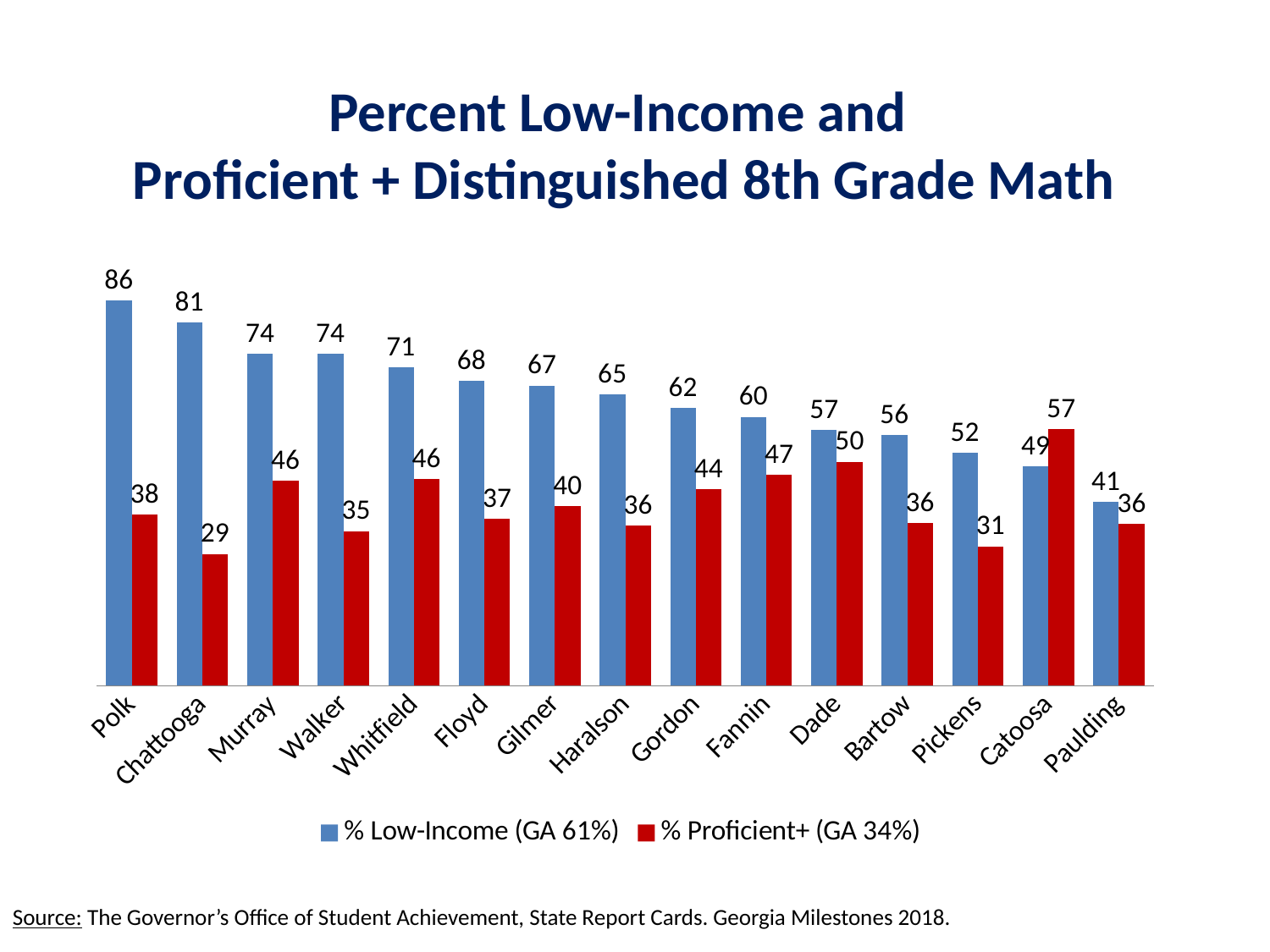
What is the difference between the % Low-Income and % Proficient+ values for Polk? 48 How many counties are shown on the x axis? 15 What kind of chart is shown on the slide? Bar chart What is the % Proficient+ value for Catoosa? 57 Which county has the lowest % Low-Income value? Paulding How many series does the legend list? 2 Which county has the highest % Proficient+ value? Catoosa Which county has the highest % Low-Income value? Polk Which county has the lowest % Proficient+ value? Chattooga What is the % Proficient+ value for Pickens? 31 What is the % Low-Income value for Polk? 86 Which county has a higher % Proficient+ value, Dade or Bartow? Dade